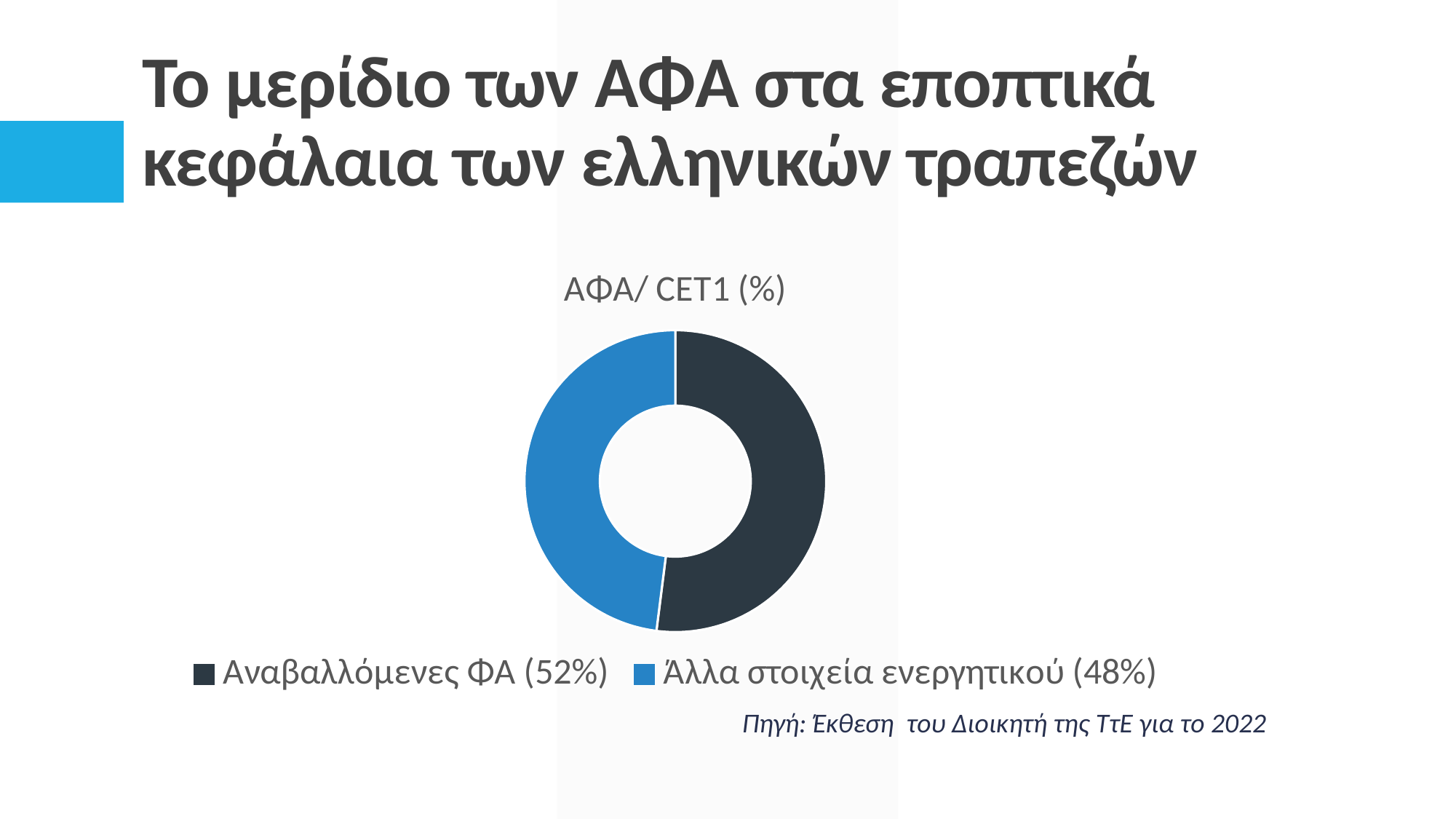
What share of the chart is Αναβαλλόμενες ΦΑ? 52% What colour is the Άλλα στοιχεία ενεργητικού slice? Blue Which slice is the smallest? Άλλα στοιχεία ενεργητικού What kind of chart is shown on the slide? Doughnut (pie) chart What share of the chart is Άλλα στοιχεία ενεργητικού? 48% What is the title of the chart? ΑΦΑ/ CET1 (%) Which slice is the largest? Αναβαλλόμενες ΦΑ What is the difference in percentage points between Αναβαλλόμενες ΦΑ and Άλλα στοιχεία ενεργητικού? 4 percentage points How many slices does the chart have? 2 Which is larger, Αναβαλλόμενες ΦΑ or Άλλα στοιχεία ενεργητικού? Αναβαλλόμενες ΦΑ What is the value for Αναβαλλόμενες ΦΑ shown in the legend? 52% Is the share for Αναβαλλόμενες ΦΑ greater or less than 50%? greater